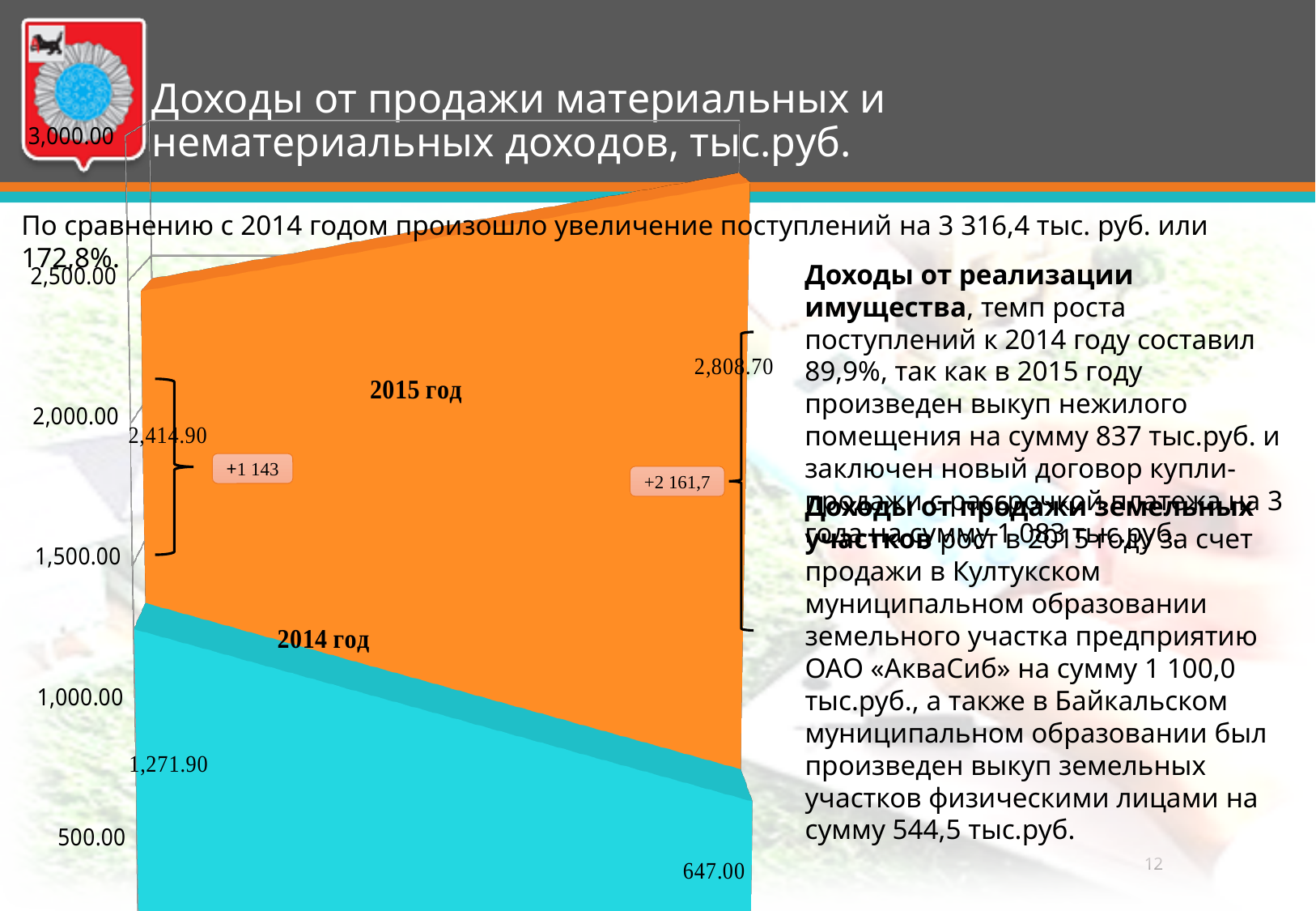
What kind of chart is shown on the slide? area chart What is the value of the 2014 год series at the left data point? 1,271.90 How many series does the chart show? 2 What is the difference between the two labeled values of the 2014 год series (1,271.90 and 647.00)? 624.90 What is the value of the 2015 год series at the right data point? 2,808.70 What is the value of the 2014 год series at the right data point? 647.00 What is the difference between the two labeled values of the 2015 год series (2,808.70 and 2,414.90)? 393.80 Does the 2014 год series rise or fall from the left data point to the right data point? fall What is the lowest labeled value in the chart? 647.00 Which is larger for the 2014 год series: the left data point or the right data point? the left data point (1,271.90) What is the value of the 2015 год series at the left data point? 2,414.90 What are the two series shown in the chart? 2014 год and 2015 год